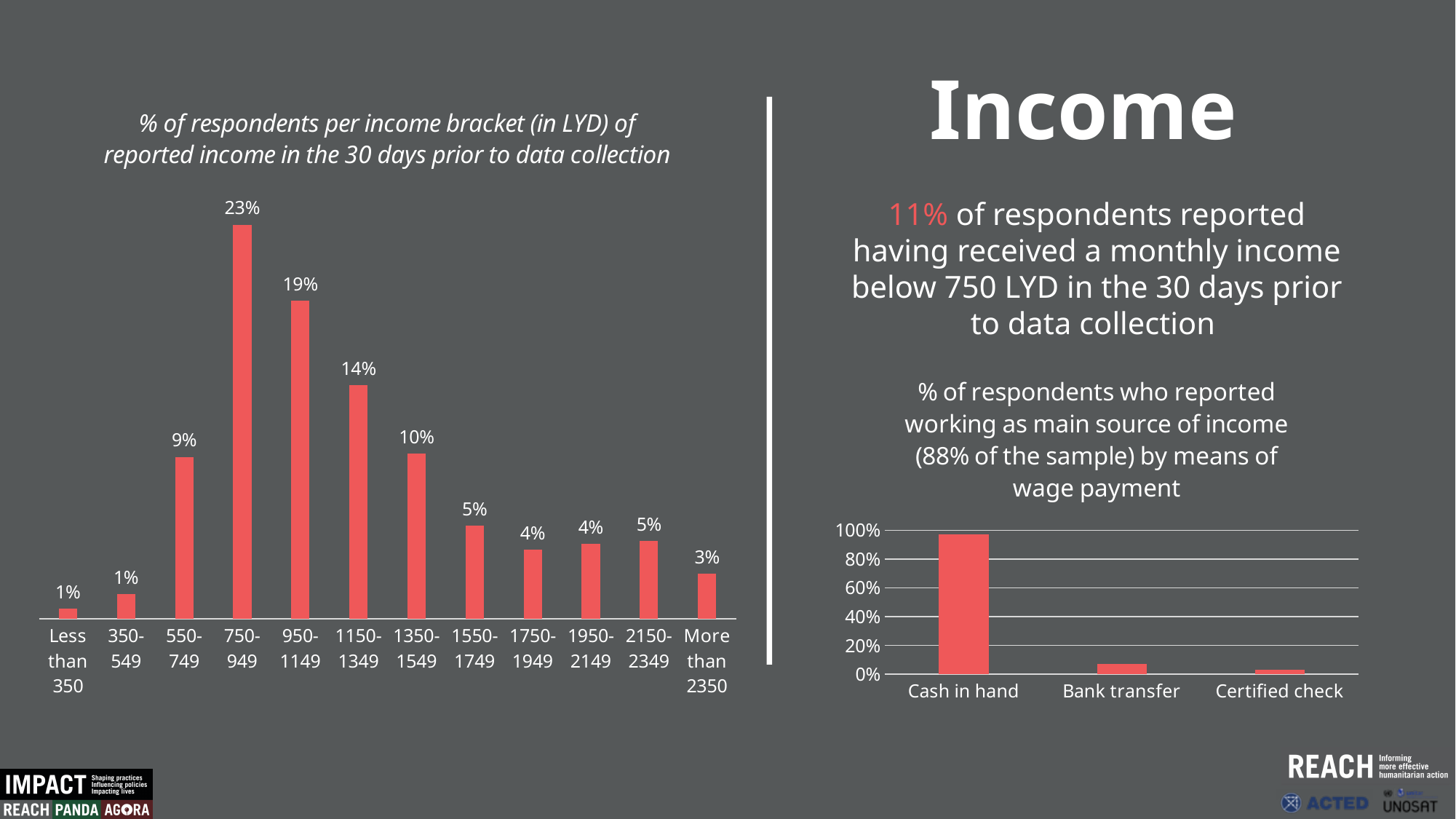
In the chart '% of respondents per income bracket (in LYD) of reported income in the 30 days prior to data collection', what is the value for the 750-949 bracket? 23% In the chart on the right about means of wage payment, which category has the highest value? Cash in hand In the chart '% of respondents per income bracket (in LYD) of reported income in the 30 days prior to data collection', what is the value for the 'More than 2350' bracket? 3% In the chart '% of respondents per income bracket (in LYD) of reported income in the 30 days prior to data collection', what is the value for the 1150-1349 bracket? 14% In the chart '% of respondents per income bracket (in LYD) of reported income in the 30 days prior to data collection', what is the difference between the 750-949 bracket and the 950-1149 bracket? 4% What kind of chart is the chart '% of respondents per income bracket (in LYD) of reported income in the 30 days prior to data collection'? Bar chart How many income brackets are shown in the chart '% of respondents per income bracket (in LYD) of reported income in the 30 days prior to data collection'? 12 In the chart on the right about means of wage payment, is the value for 'Cash in hand' greater or less than 80%? greater How many categories are shown in the chart on the right about means of wage payment? 3 In the chart '% of respondents per income bracket (in LYD) of reported income in the 30 days prior to data collection', which income bracket has the highest value? 750-949 In the chart on the right about means of wage payment, is the value for 'Bank transfer' greater or less than 20%? less In the chart '% of respondents per income bracket (in LYD) of reported income in the 30 days prior to data collection', which is larger: the value for 550-749 or the value for 1350-1549? 1350-1549